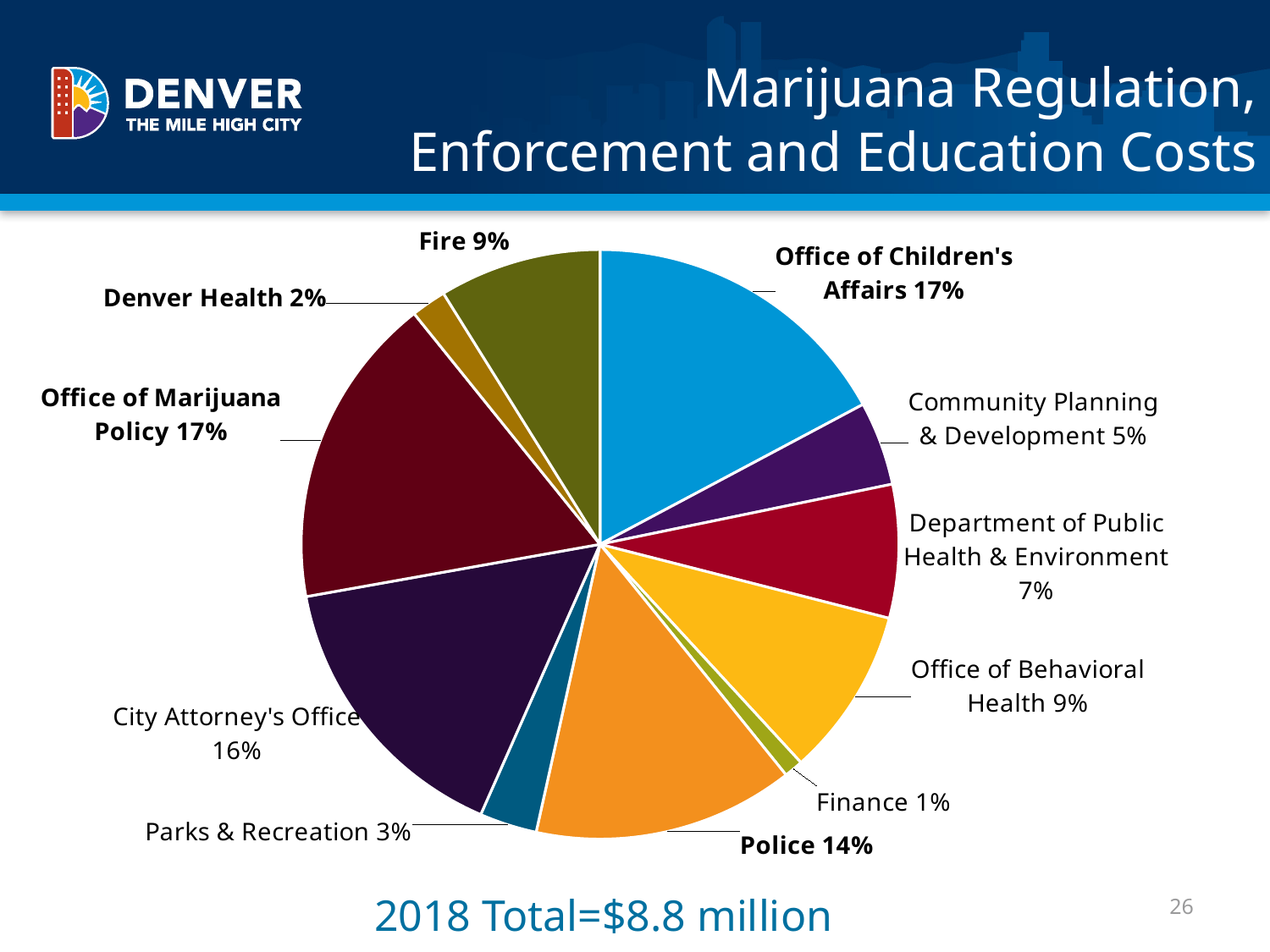
Which is larger, the share for Police or the share for the City Attorney's Office? City Attorney's Office What is the difference in percentage points between Office of Children's Affairs and Office of Behavioral Health? 8 What total amount is stated below the pie chart for 2018? $8.8 million What is the difference in percentage points between Parks & Recreation and Finance? 2 What share does Denver Health have in the pie chart? 2% What share of the pie does Police account for? 14% Which is larger, the share for Fire or the share for Department of Public Health & Environment? Fire What kind of chart is shown on the slide? pie chart What percentage is shown for the City Attorney's Office? 16% Which category has the smallest slice of the pie? Finance What percentage is shown for Community Planning & Development? 5% How many slices does the pie chart have? 11